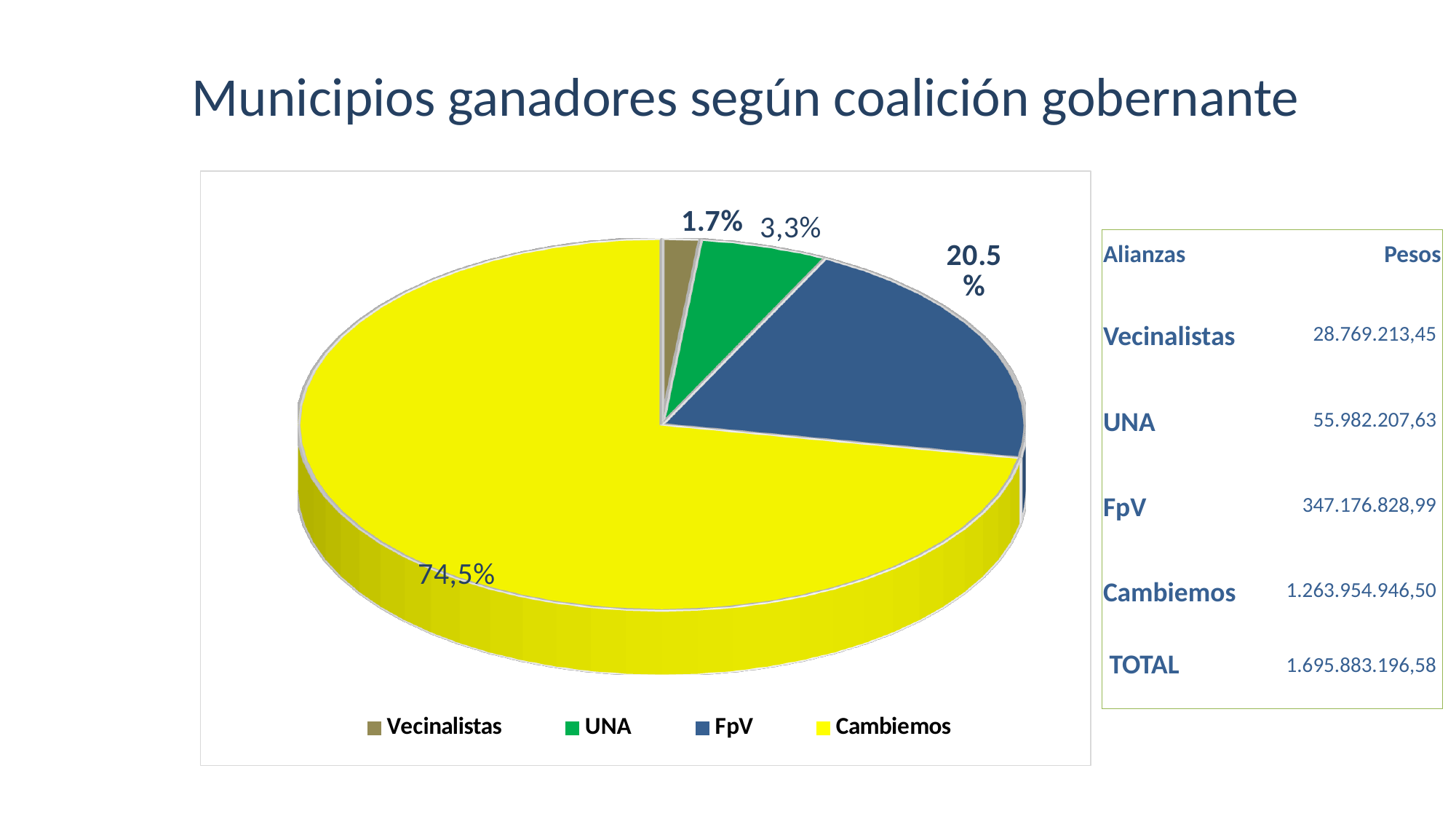
What share of the pie does Vecinalistas hold? 1.7% What is the title of the slide? Municipios ganadores según coalición gobernante Which slice is larger, FpV or UNA? FpV What share of the pie does Cambiemos hold? 74,5% How many entries does the legend list? 4 Which coalition has the largest slice of the pie? Cambiemos What share of the pie does FpV hold? 20.5% Which coalition has the smallest slice of the pie? Vecinalistas What colour is the Cambiemos slice in the pie chart? yellow What kind of chart is shown on the slide? pie chart How many slices does the pie chart have? 4